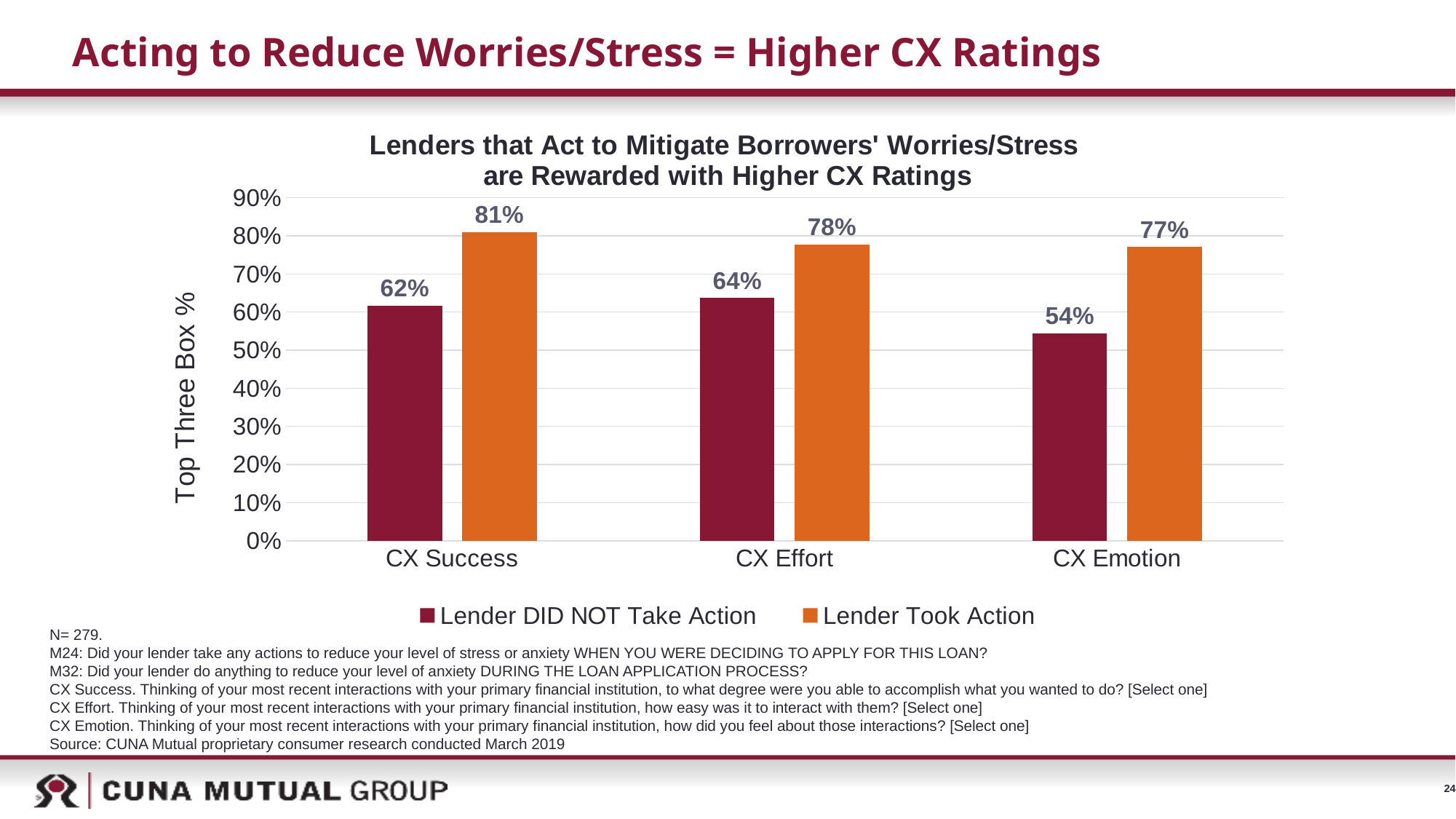
What is the label of the y axis? Top Three Box % Which category has the highest value for Lender Took Action? CX Success Which is larger in the CX Effort category: Lender Took Action or Lender DID NOT Take Action? Lender Took Action What kind of chart is shown on the slide? bar chart What is the value for Lender Took Action in the CX Success category? 81% How many categories are shown on the x axis? 3 What is the value for Lender DID NOT Take Action in the CX Effort category? 64% Is the value for Lender DID NOT Take Action in CX Success greater or less than 70%? less What is the value for Lender DID NOT Take Action in the CX Emotion category? 54% Which category has the lowest value for Lender DID NOT Take Action? CX Emotion How many series does the legend list? 2 What is the difference between Lender Took Action and Lender DID NOT Take Action in the CX Emotion category? 23%